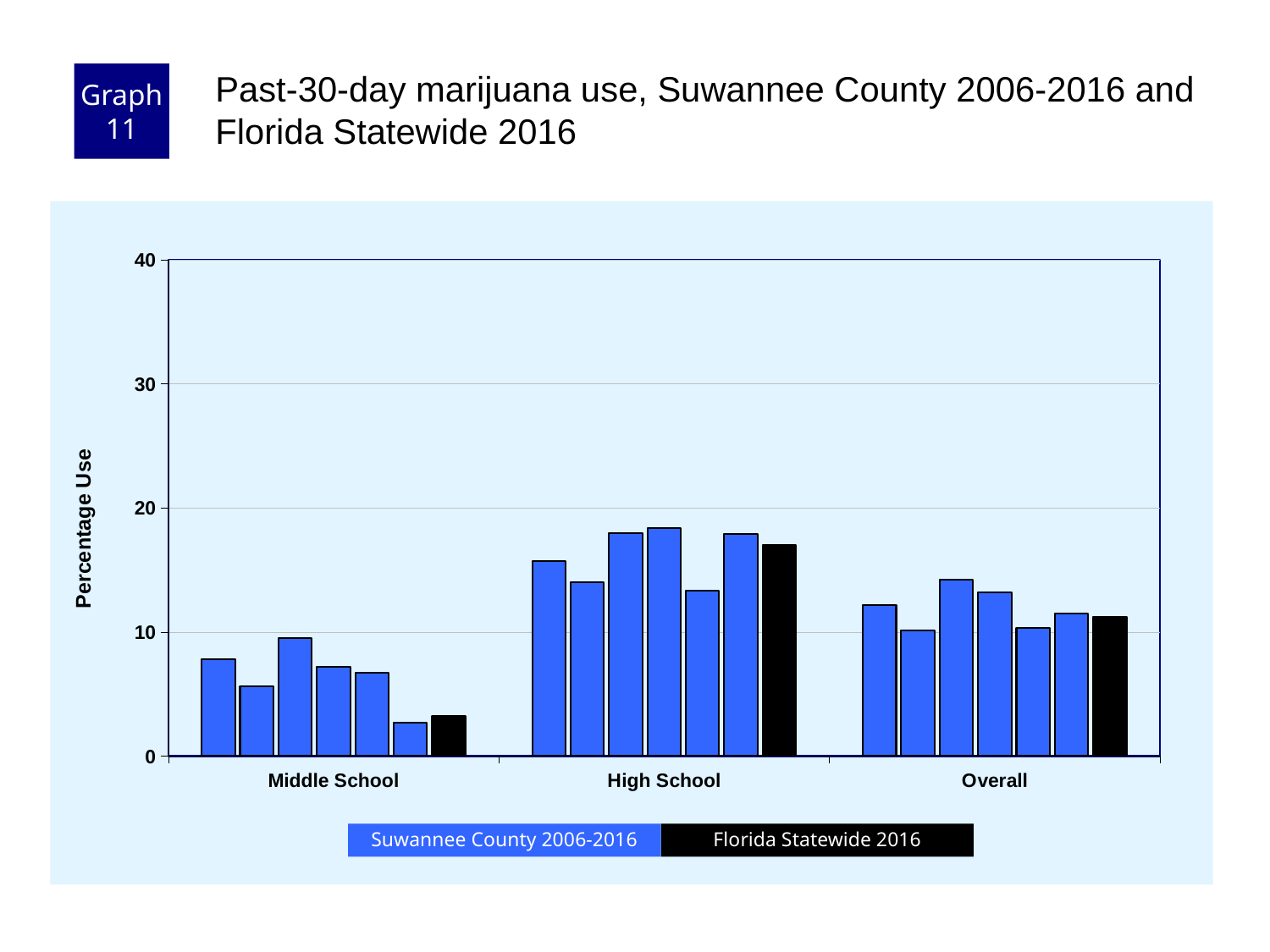
Which category has the lowest Florida Statewide 2016 value? Middle School Is the Florida Statewide 2016 value for High School greater or less than 10? greater Which category has the highest Florida Statewide 2016 value? High School Is the Florida Statewide 2016 value for Overall greater or less than 10? greater How many series does the legend list? 2 Which is larger, the Florida Statewide 2016 value for High School or for Middle School? High School What kind of chart is shown on the slide? bar chart Is the Florida Statewide 2016 value for Middle School greater or less than 10? less How many categories are shown along the x axis? 3 Which is larger, the Florida Statewide 2016 value for Overall or for Middle School? Overall What is the title of the y axis? Percentage Use